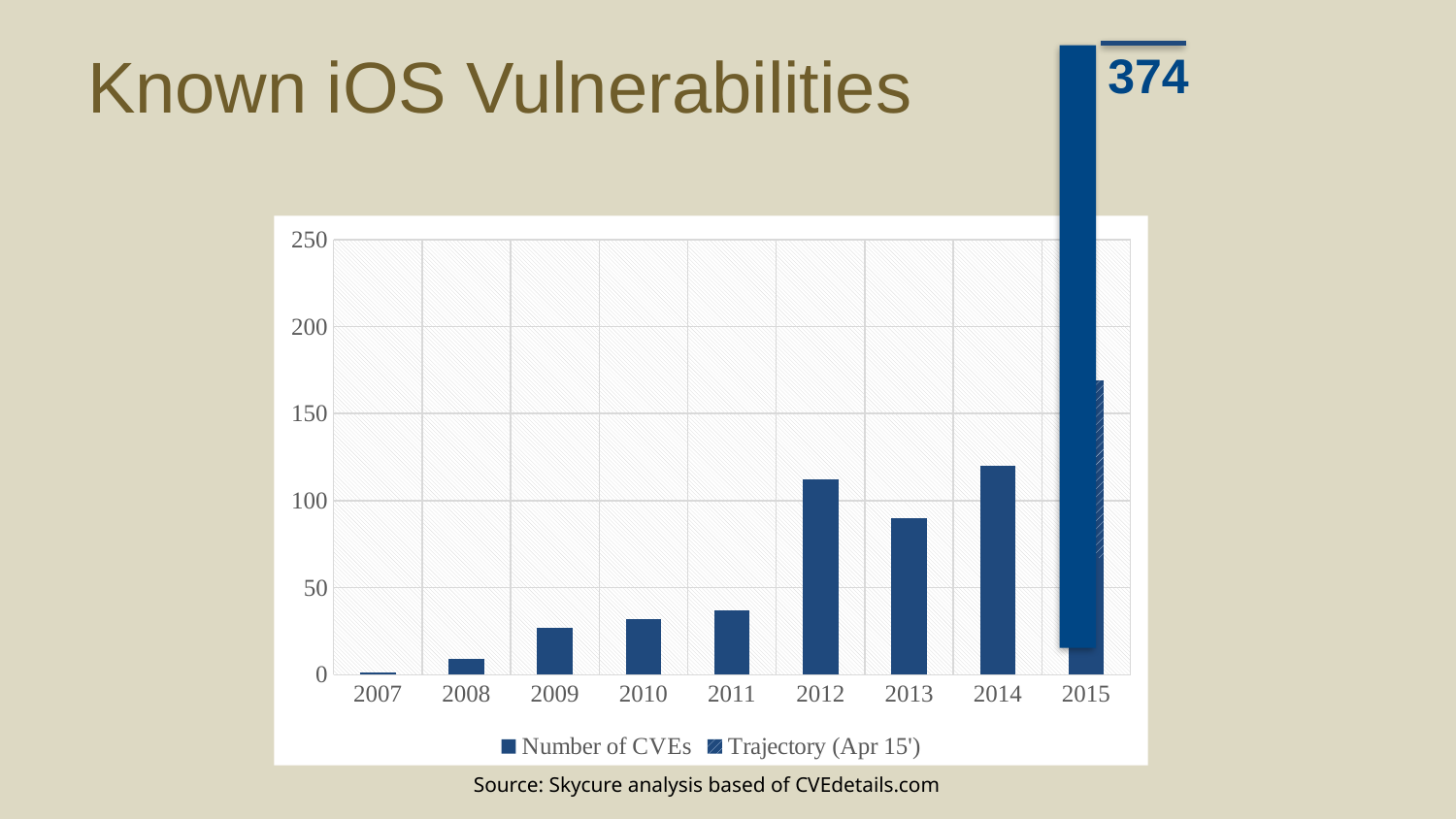
Is the number of CVEs for 2011 greater or less than 50? less Is the number of CVEs for 2012 greater or less than 100? greater Which year has more CVEs, 2013 or 2014? 2014 What kind of chart is shown on the slide? bar chart What is the source cited below the chart? Skycure analysis based of CVEdetails.com How many series does the legend list? 2 Which year has the lowest number of CVEs? 2007 What value is labelled on the 2015 bar? 374 Which year has the highest number of CVEs? 2015 Is the number of CVEs for 2013 greater or less than 100? less How many years are shown on the x axis? 9